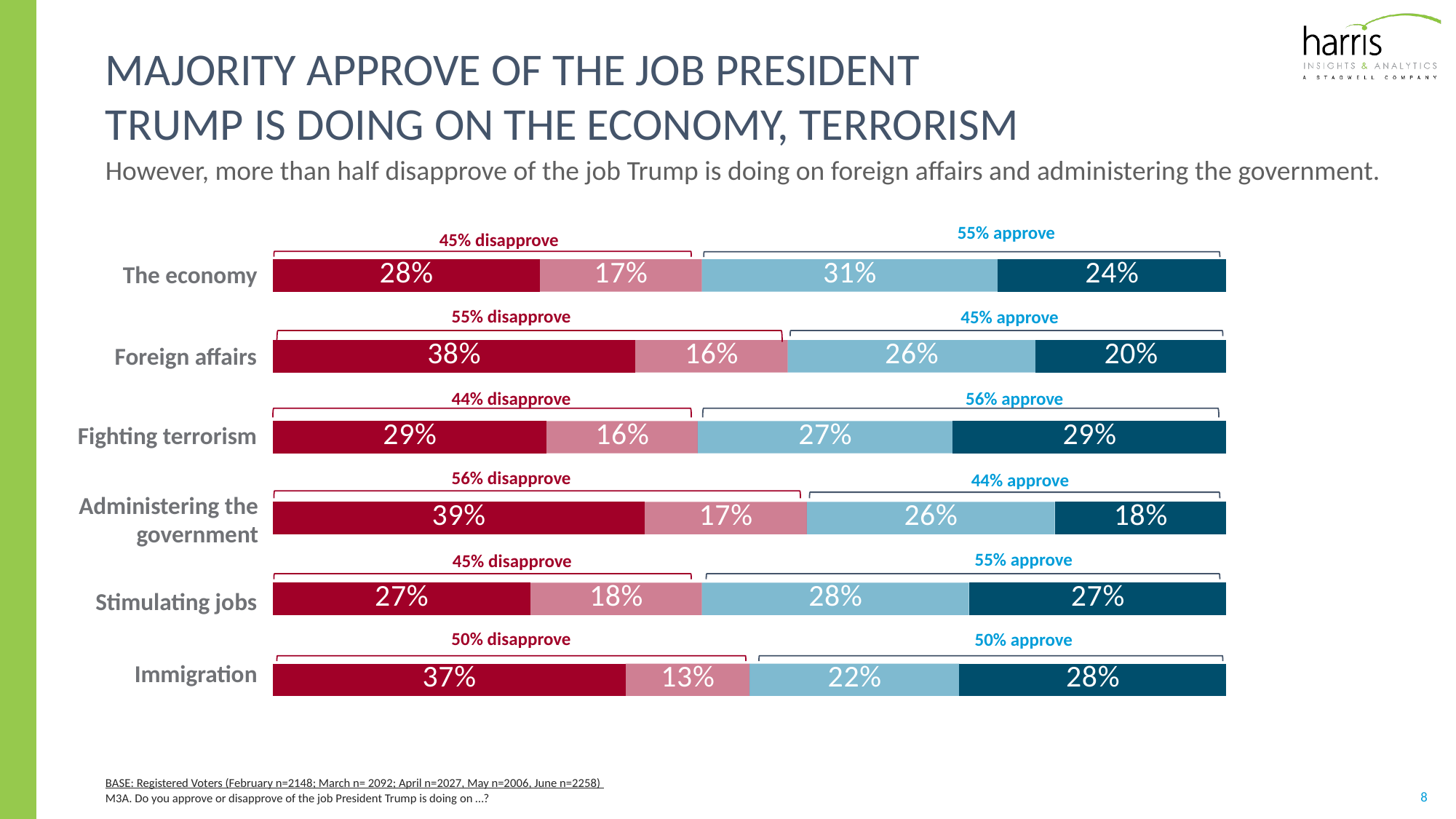
How many segments make up each bar in the chart? 4 What is the value of the leftmost (dark red) segment for Immigration? 37% How many issue categories are plotted in the chart? 6 What is the total disapprove share shown for Foreign affairs? 55% By how many percentage points does the disapprove share exceed the approve share for Foreign affairs? 10 percentage points What is the total of the two red segments for Stimulating jobs? 45% Which issue has the lowest total approve share? Administering the government Which has a larger total disapprove share, Administering the government or Immigration? Administering the government What is the total approve share shown for Fighting terrorism? 56% Which issue has the highest total approve share? Fighting terrorism What kind of chart is shown on the slide? Stacked bar chart What is the value of the rightmost (dark blue) segment for The economy? 24%